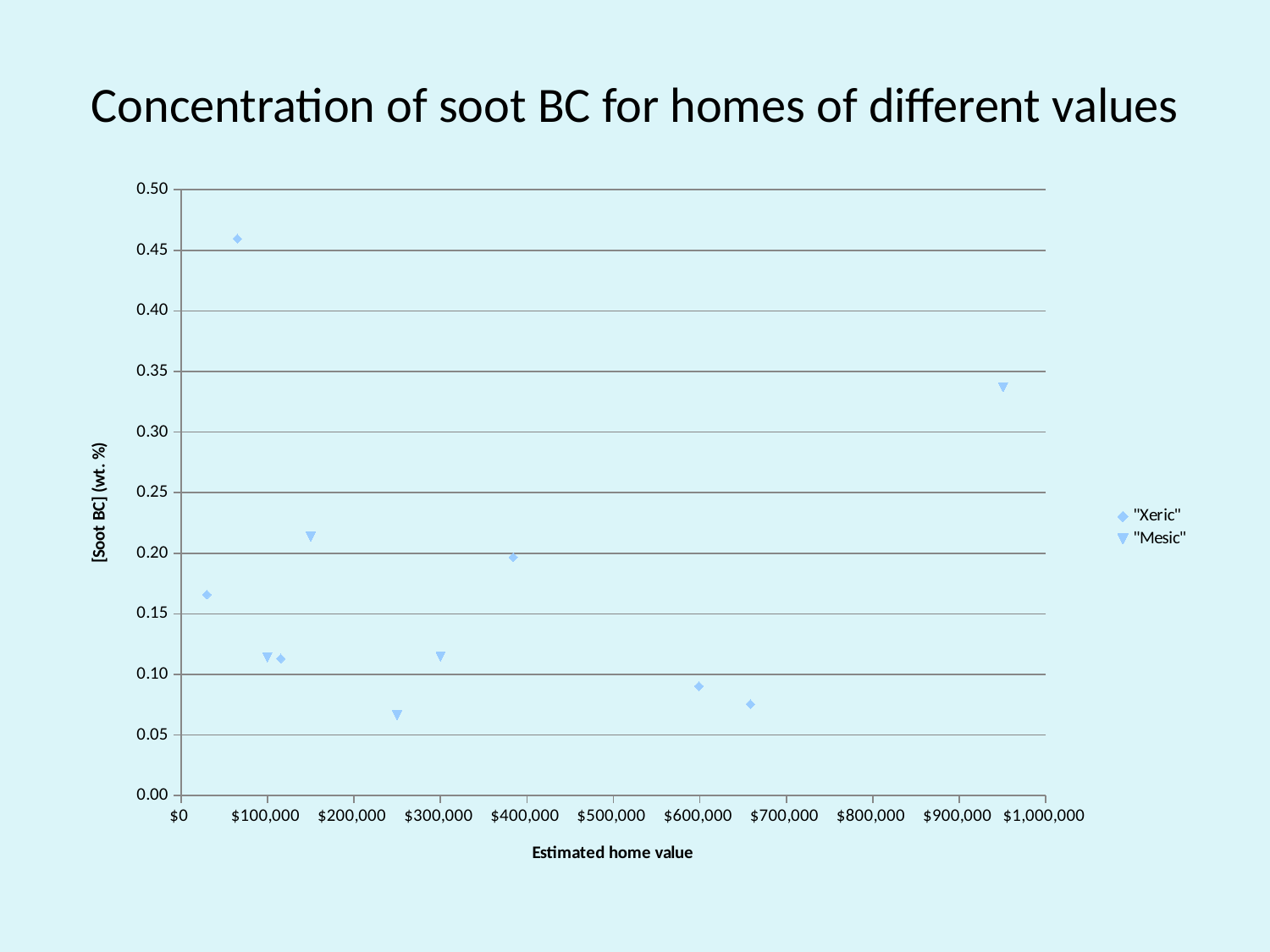
Which is larger: the "Mesic" point near $150,000 or the "Mesic" point near $300,000? The "Mesic" point near $150,000 How many data points are plotted in total across both series? 11 How many "Mesic" data points are plotted? 5 Is the "Mesic" point near $950,000 greater or less than 0.30 wt. %? greater What are the two series named in the legend? "Xeric" and "Mesic" What kind of chart is shown on the slide? Scatter chart Which series contains the point with the highest soot BC concentration? "Xeric" How many series does the legend list? 2 Is the "Mesic" point near $250,000 greater or less than 0.10 wt. %? less What is the label of the y axis? [Soot BC] (wt. %) How many "Xeric" data points are plotted? 6 Is the highest "Xeric" point greater or less than 0.40 wt. %? greater